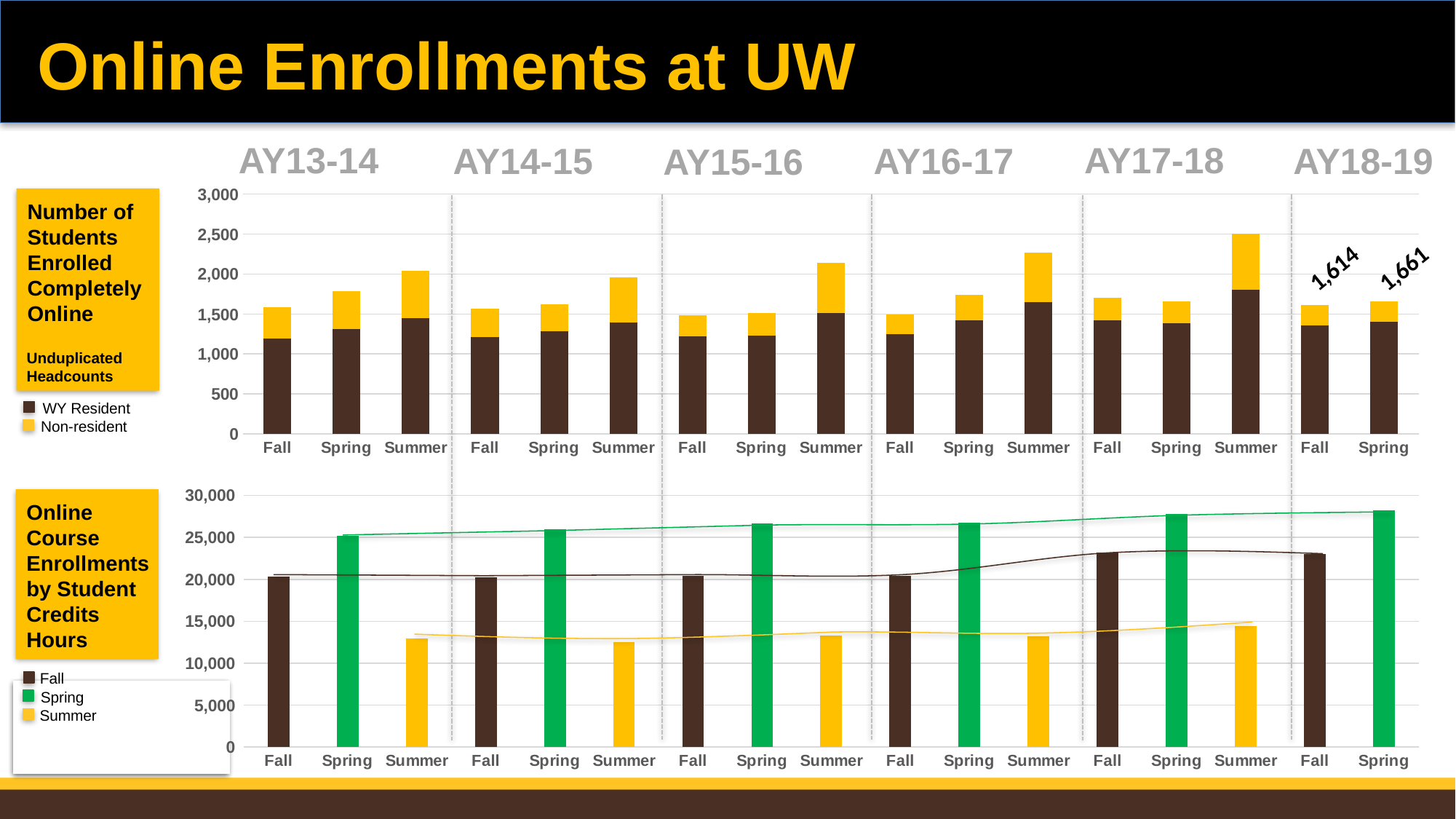
What kind of chart is the top chart (Number of Students Enrolled Completely Online)? Stacked bar chart In the top chart (Number of Students Enrolled Completely Online), what is the total number of students for Fall of AY18-19? 1,614 How many bars are plotted in the bottom chart? 17 How many series does the legend of the top chart list? 2 In the bottom chart, is the value for Fall of AY17-18 greater or less than 20,000? greater In the top chart, which is larger: the AY18-19 Fall total or the AY18-19 Spring total? AY18-19 Spring In the top chart, what is the difference between the AY18-19 Spring total and the AY18-19 Fall total? 47 In the top chart, is the total for Summer of AY16-17 greater or less than 2,000? greater In the top chart, which term has the tallest stacked bar? Summer AY17-18 In the top chart (Number of Students Enrolled Completely Online), what is the total number of students for Spring of AY18-19? 1,661 How many series does the legend of the bottom chart (Online Course Enrollments by Student Credits Hours) list? 3 In the bottom chart, do the Spring bars rise or fall from AY13-14 to AY18-19? Rise